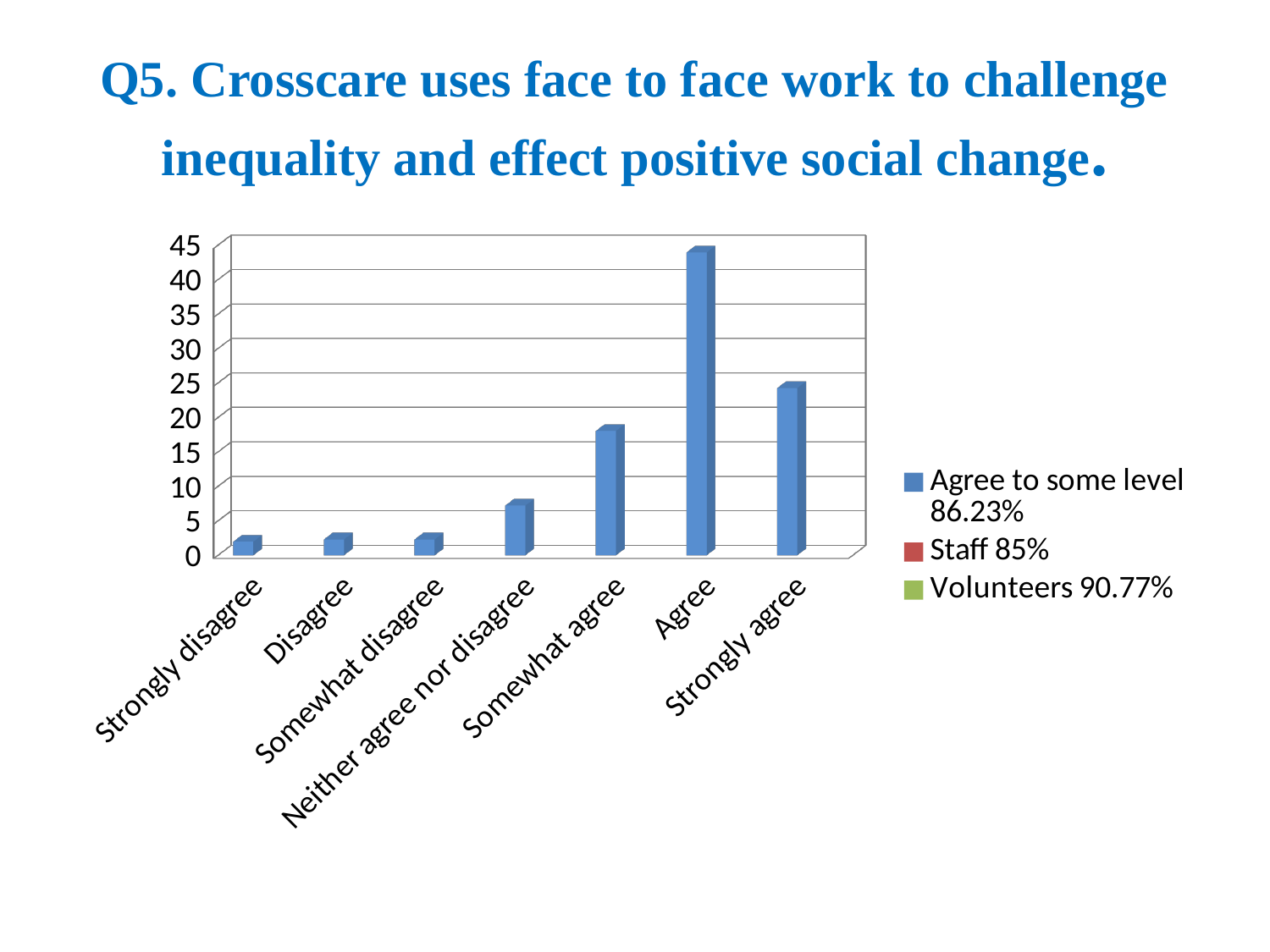
Is the value for Neither agree nor disagree greater or less than 10? less How many categories are shown on the x axis of the chart? 7 Is the value for Agree greater or less than 40? greater What kind of chart is shown on the slide? bar chart Do the values generally rise or fall along the x axis from Strongly disagree to Agree? rise What percentage is shown in the legend entry for Volunteers? 90.77% Which is larger, the value for Strongly agree or the value for Somewhat agree? Strongly agree Which category has the highest bar? Agree How many entries does the chart's legend list? 3 Is the value for Somewhat agree greater or less than 20? less Which is larger, the value for Agree or the value for Strongly agree? Agree